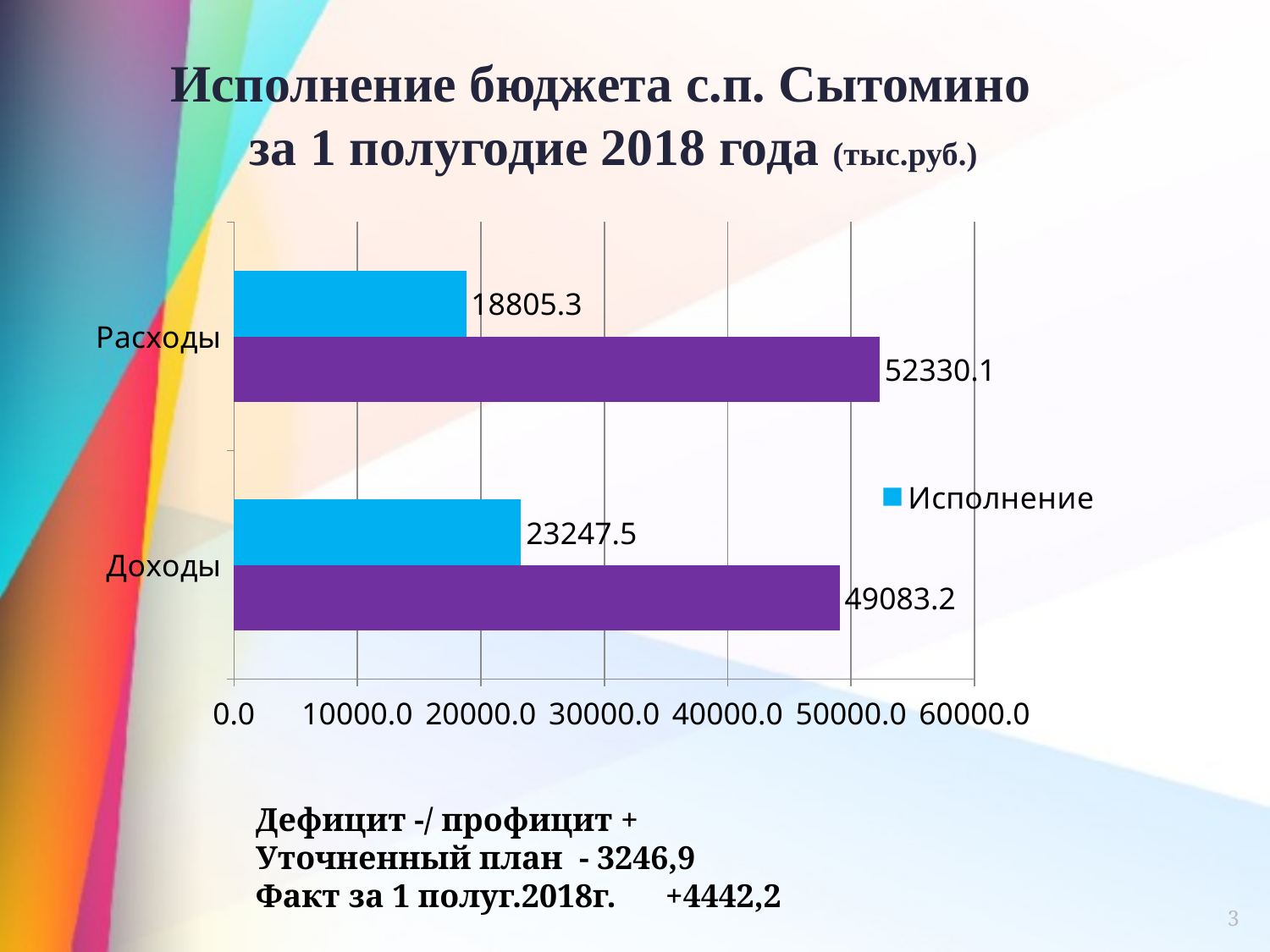
What value is shown on the purple bar for Расходы? 52330.1 What is the difference between the purple bar values for Расходы and Доходы? 3246.9 What is the difference between the Исполнение values for Доходы and Расходы? 4442.2 Which category has the higher Исполнение value? Доходы What is the Исполнение value for Доходы? 23247.5 What value is shown on the purple bar for Доходы? 49083.2 What is the Исполнение value for Расходы? 18805.3 Which purple bar is longer, Расходы or Доходы? Расходы For Расходы, what is the difference between the purple bar and the Исполнение bar? 33524.8 How many categories are shown on the chart? 2 Is the Исполнение value for Расходы greater or less than 20000.0? less What kind of chart is shown on the slide? bar chart